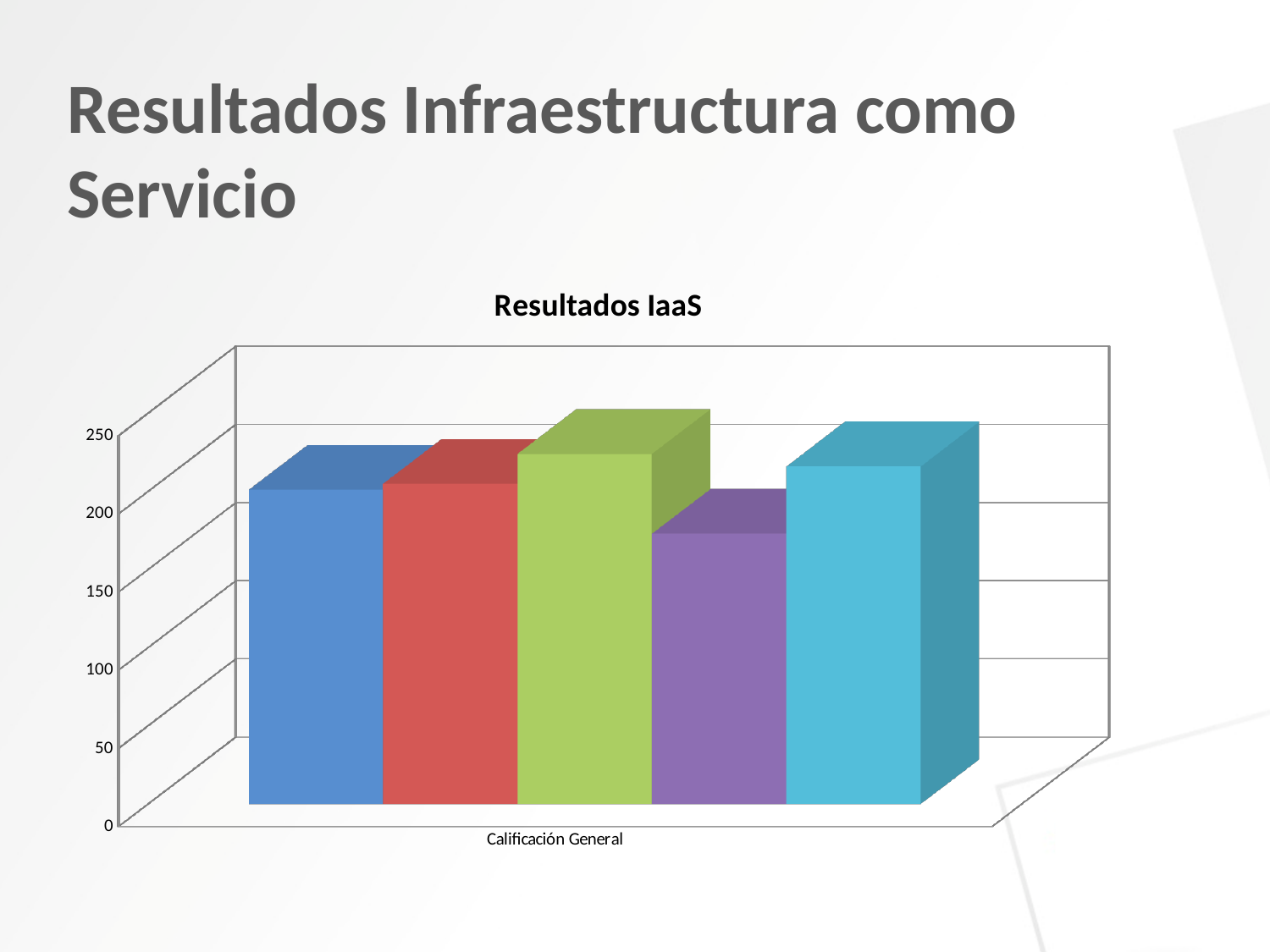
Is the value of the purple bar greater or less than 250? less How many bars are plotted in the chart? 5 How many categories are shown on the x axis of the chart? 1 Is the value of the green bar greater or less than 150? greater What is the category label shown on the x axis of the chart? Calificación General What kind of chart is shown on the slide? bar chart Which is taller, the green bar or the purple bar? the green bar Which bar is the shortest in the chart? the purple bar What is the title of the chart? Resultados IaaS Is the value of the purple bar greater or less than 100? greater What is the highest value shown on the vertical axis of the chart? 250 Which bar is the tallest in the chart? the green bar